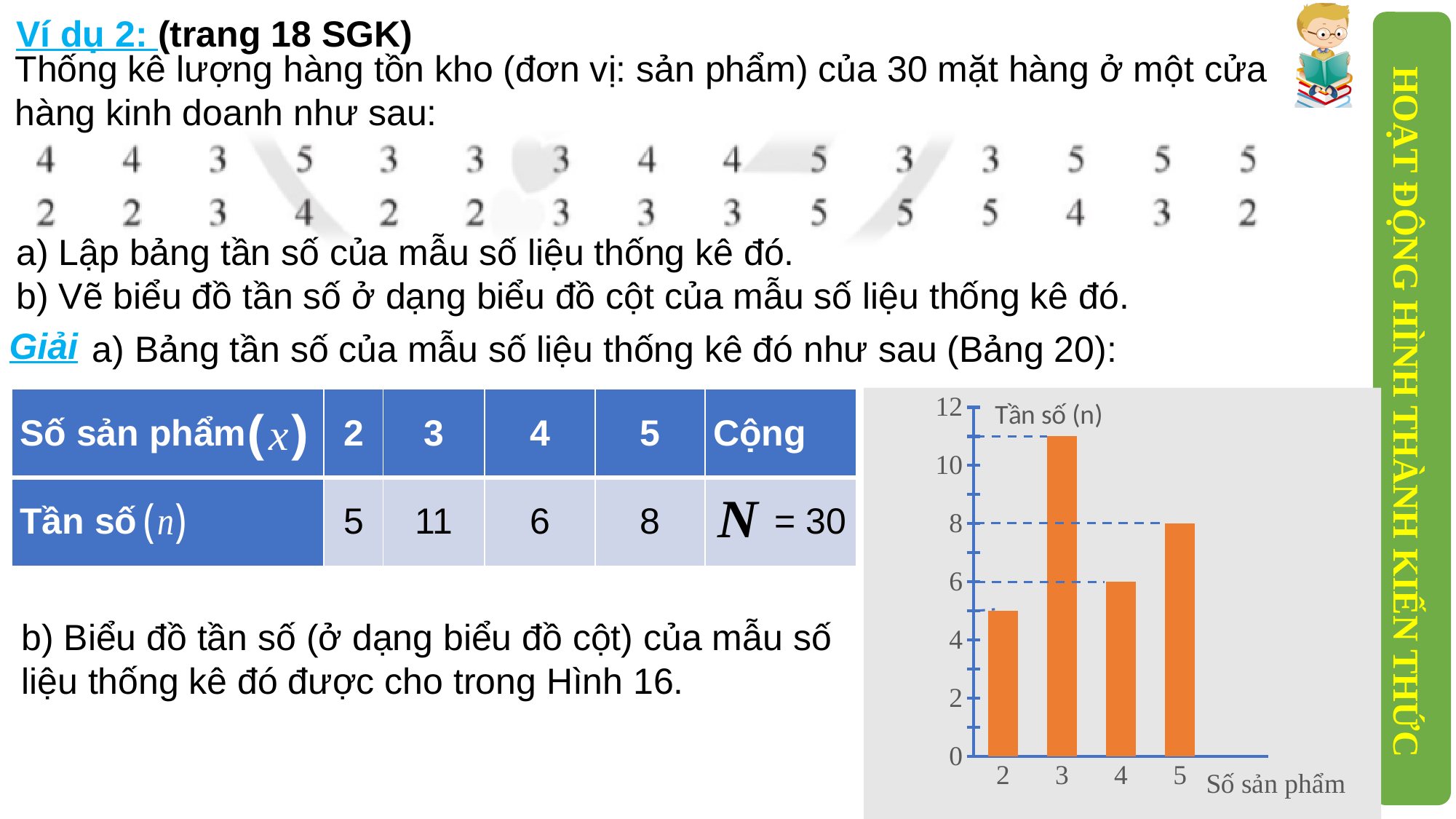
What is the frequency (Tần số) for 3 products (Số sản phẩm = 3) in the chart? 11 Is the frequency for 3 products greater or less than 10? greater Which value of Số sản phẩm has the lowest bar in the chart? 2 Which value of Số sản phẩm has the highest bar in the chart? 3 Do the bar heights rise or fall from Số sản phẩm 3 to 4? fall Which has a larger frequency: 4 products or 5 products? 5 products What is the difference between the frequency for 3 products and the frequency for 4 products? 5 What is the frequency for 5 products in the chart? 8 What kind of chart is shown on the slide? bar chart How many bars (categories) are plotted in the chart? 4 What label is written on the vertical axis of the chart? Tần số (n) What is the frequency for 2 products in the chart? 5